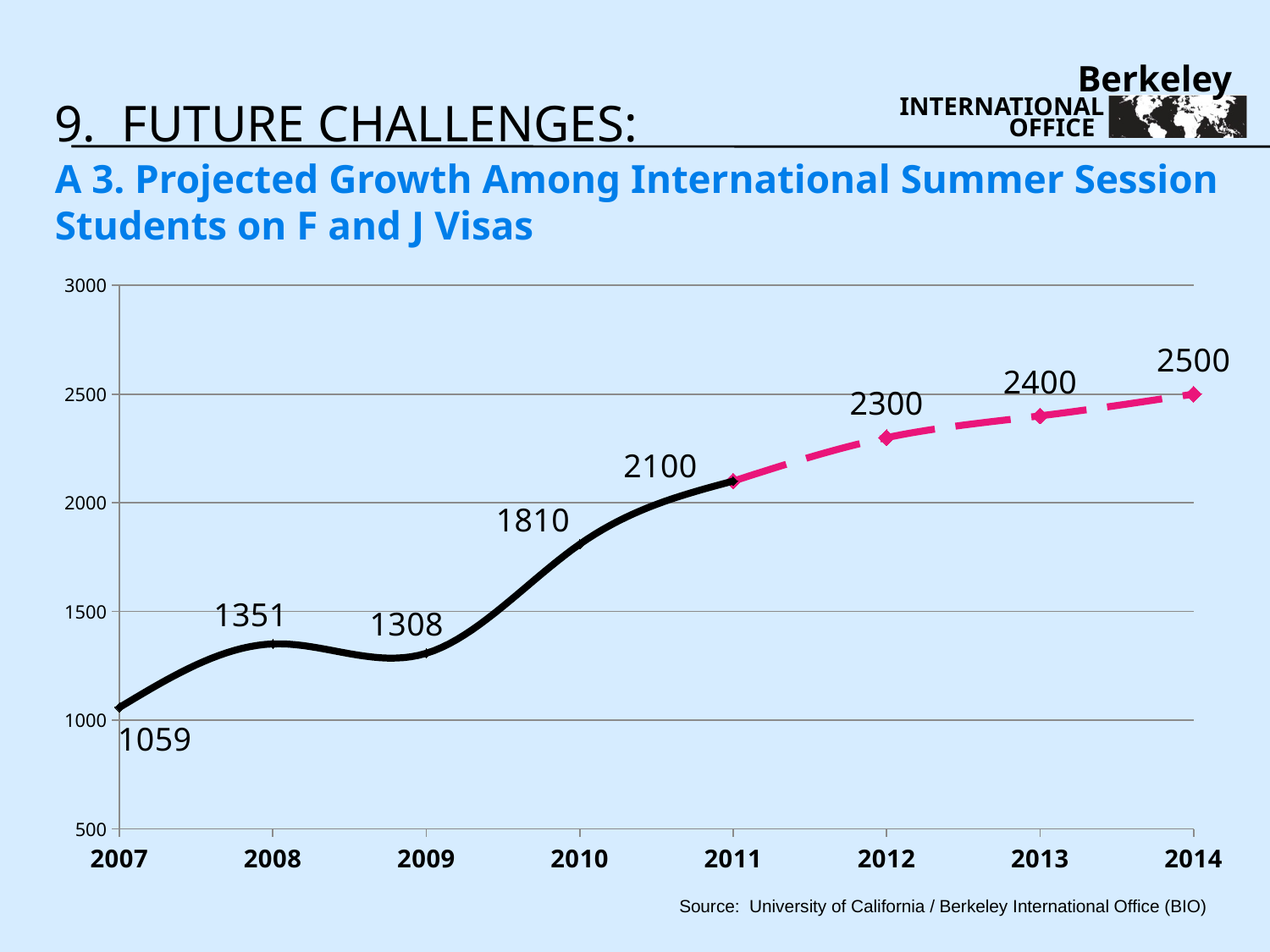
Which year has the lowest value? 2007 What is the difference between the values for 2008 and 2009? 43 Which year has the highest value? 2014 What kind of chart is shown on the slide? line chart Which is larger, the value for 2008 or the value for 2009? 2008 How many years are plotted on the x axis? 8 What is the value for 2007? 1059 Is the value for 2012 greater or less than 2000? greater What is the value for 2013? 2400 What is the difference between the values for 2011 and 2010? 290 What is the value for 2010? 1810 Do the values generally rise or fall from 2009 to 2014? rise